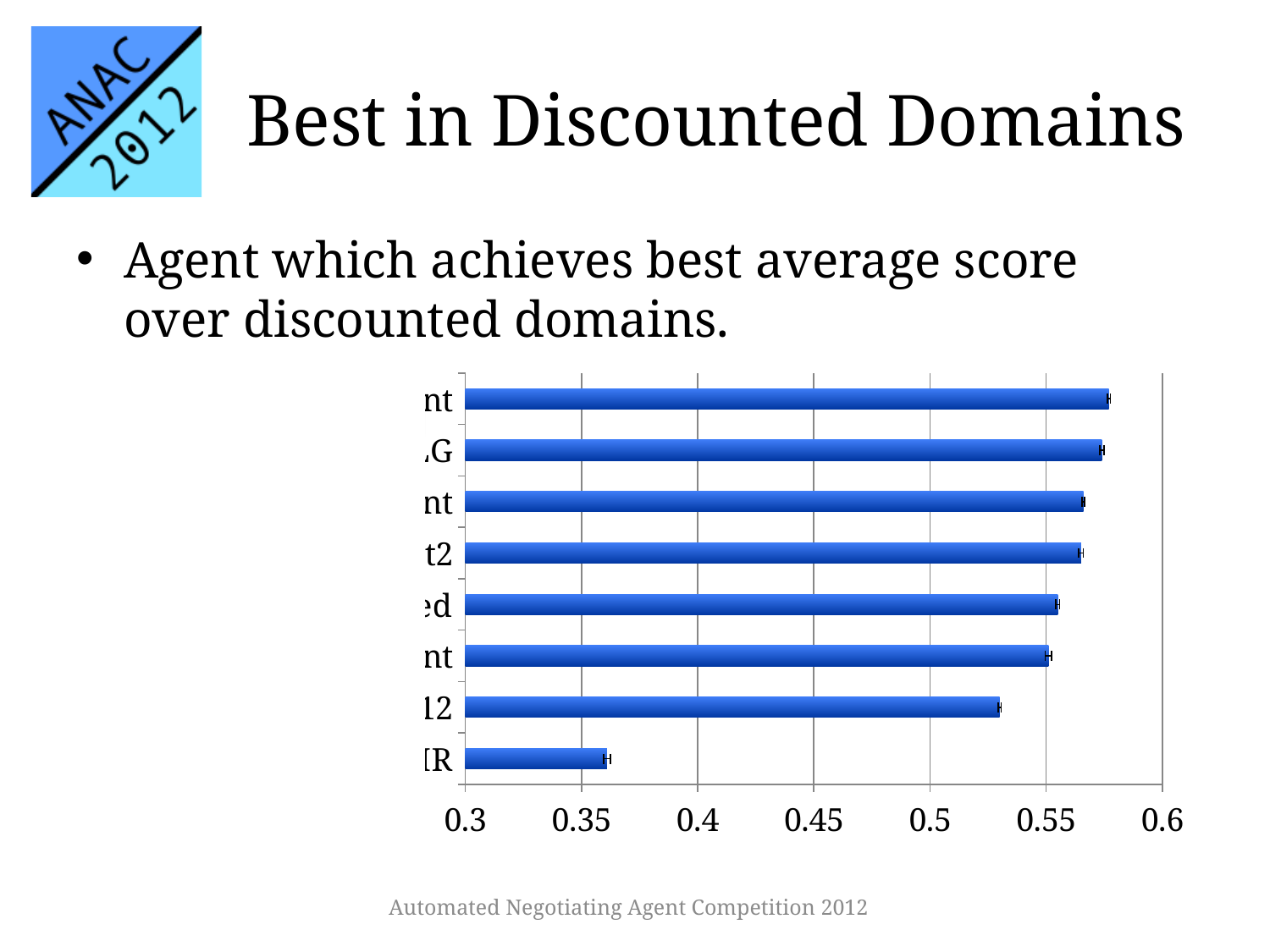
How many bars does the chart contain? 8 What is the highest value shown on the horizontal axis? 0.6 Which is larger, the value of the top bar or the value of the bottom bar? the top bar Which bar is the shortest in the chart, the top one or the bottom one? the bottom one What kind of chart is shown on the slide? bar chart Is the value of the bottom bar greater or less than 0.4? less Is the value of the bottom bar greater or less than 0.35? greater Do the bar values increase or decrease going from the top bar to the bottom bar? decrease Is the value of the second bar from the bottom greater or less than 0.55? less What is the lowest value shown on the horizontal axis? 0.3